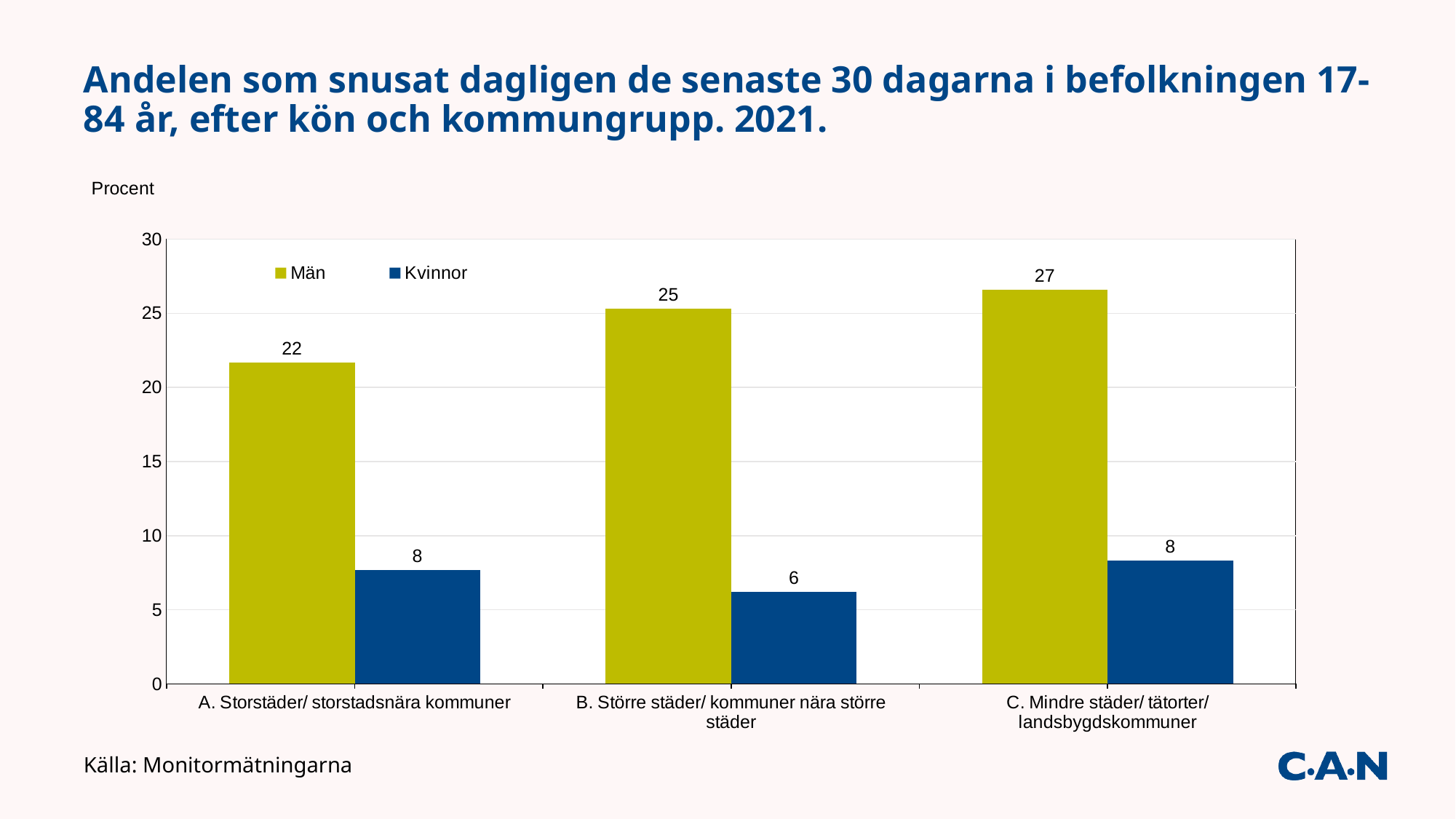
What kind of chart is shown on the slide? Bar chart How many municipality groups are shown on the x axis? 3 How many series does the legend list? 2 Which municipality group has the highest value for Män? C. Mindre städer/ tätorter/ landsbygdskommuner Is the value for Män in group C. Mindre städer/ tätorter/ landsbygdskommuner greater or less than 25? greater Which municipality group has the lowest value for Kvinnor? B. Större städer/ kommuner nära större städer Do the Män values rise or fall from group A to group C? Rise What is the value for Kvinnor in group B. Större städer/ kommuner nära större städer? 6 What is the value for Män in group C. Mindre städer/ tätorter/ landsbygdskommuner? 27 What is the difference between the Män and Kvinnor values in group B. Större städer/ kommuner nära större städer? 19 What is the value for Män in group A. Storstäder/ storstadsnära kommuner? 22 Which is larger: the Män value in group A or the Män value in group B? Män in group B